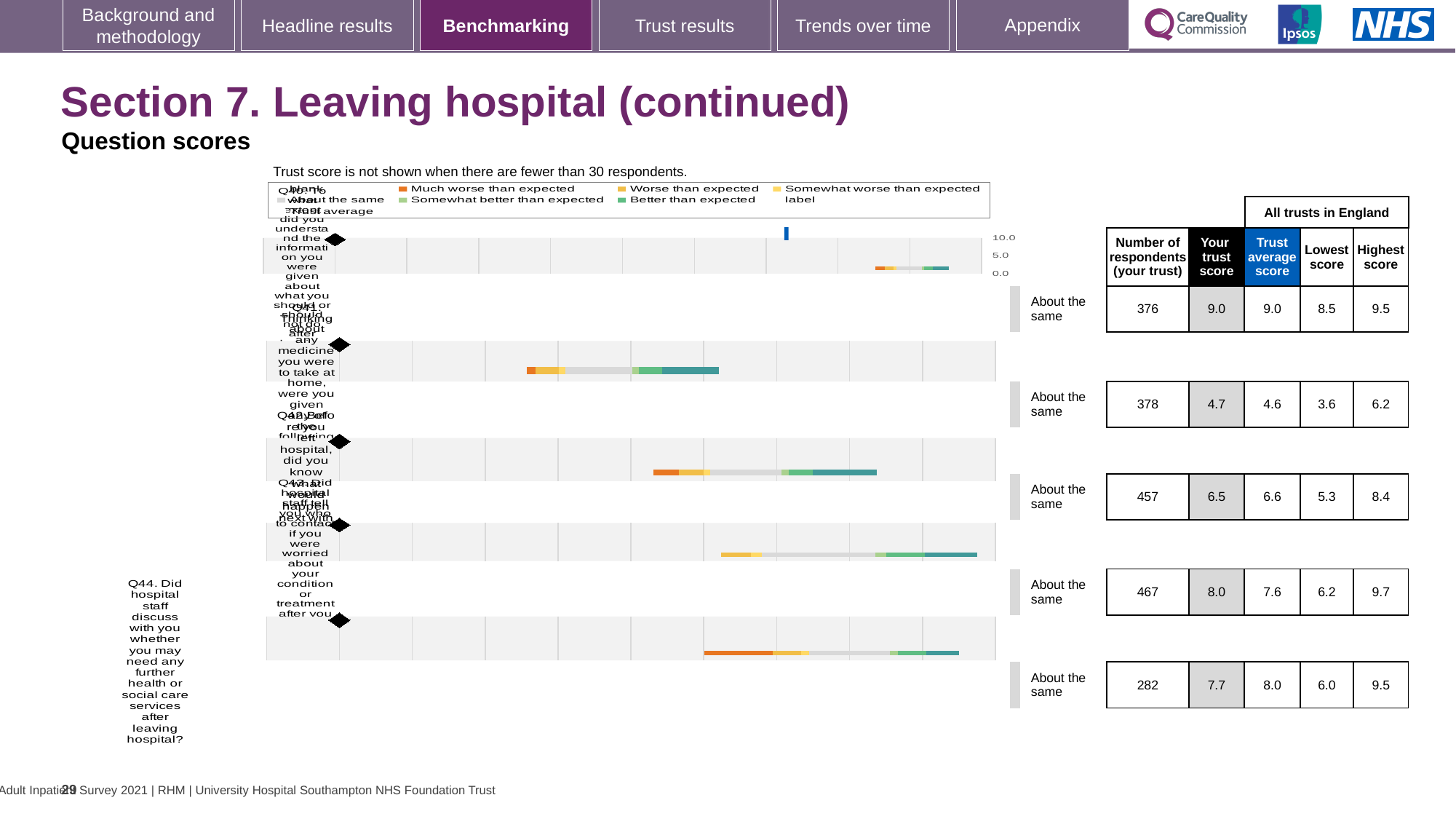
How many question rows are shown in the benchmarking chart and table? 5 What is your trust score for Q44, the last row about further health or social care services after leaving hospital? 7.7 What is the trust average score for the first question row in the table? 9.0 What is the highest score across all trusts in England for the second question row (378 respondents)? 6.2 Which question row has the highest number of respondents (your trust)? the fourth row (467) What is the lowest score across all trusts in England for the fourth question row (467 respondents)? 6.2 For the fourth question row, which is larger: your trust score or the trust average score? your trust score Which question row has the lowest 'Your trust score' in the table? the second row (4.7) What is the difference between the highest score and the lowest score for the third question row (457 respondents)? 3.1 What is the number of respondents (your trust) for Q44, the last row about further health or social care services after leaving hospital? 282 What kind of chart is used to show the question scores on this slide? bar chart What benchmark category is shown for every question row on this slide? About the same